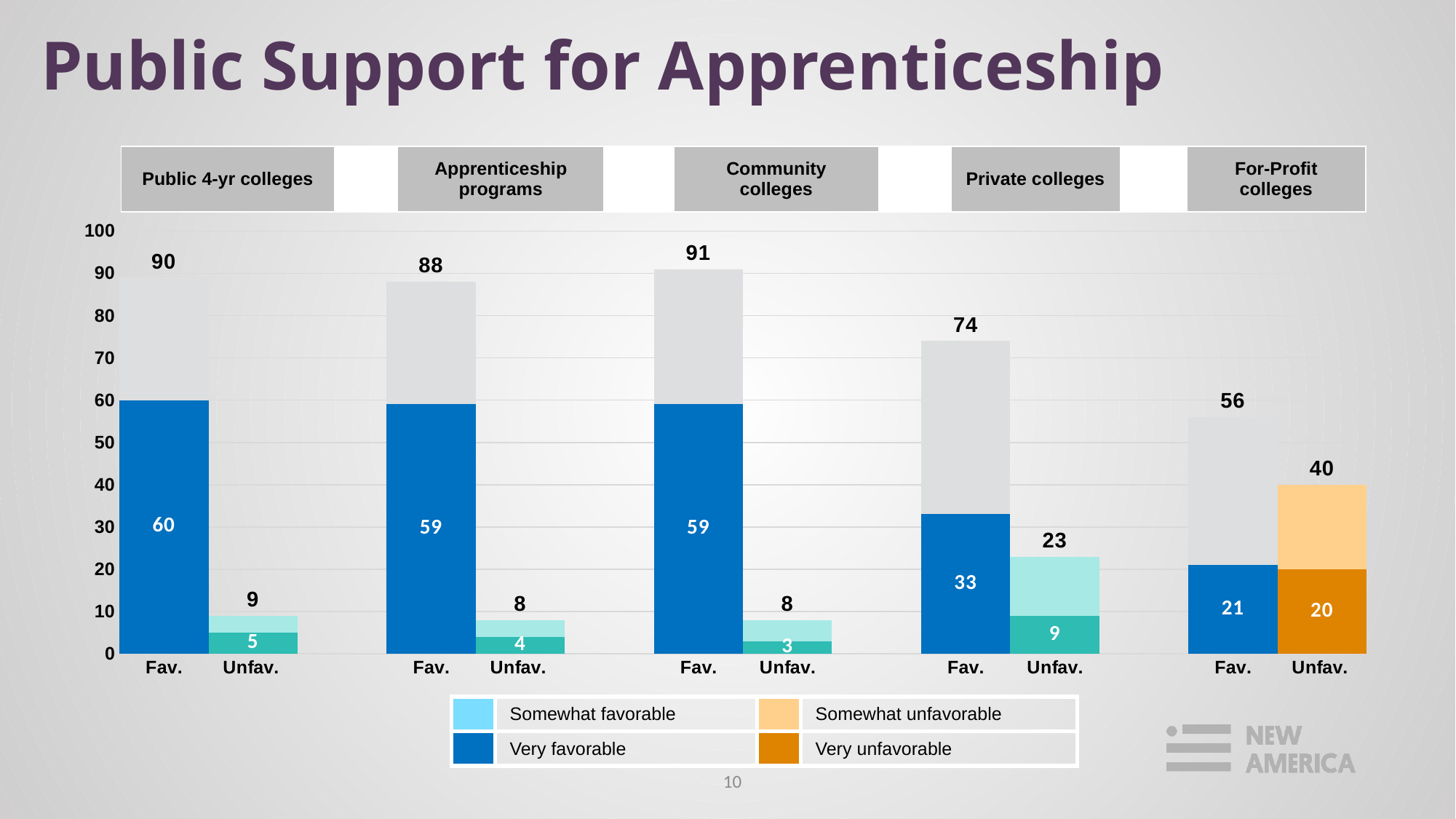
Which is larger: the total unfavorable value for Private colleges or for For-Profit colleges? For-Profit colleges What kind of chart is shown on the slide? Stacked bar chart What is the Very unfavorable value for For-Profit colleges? 20 What is the total favorable value for Community colleges? 91 What is the Somewhat unfavorable value for For-Profit colleges (total unfavorable minus very unfavorable)? 20 Which group has the lowest total favorable value? For-Profit colleges Which group has the highest total favorable value? Community colleges What is the difference between the total favorable values for Public 4-yr colleges and For-Profit colleges? 34 How many series does the legend list? 4 Is the total favorable value for Private colleges greater or less than 70? greater How many groups (institution types) are shown on the chart? 5 What is the Very favorable value for Private colleges? 33